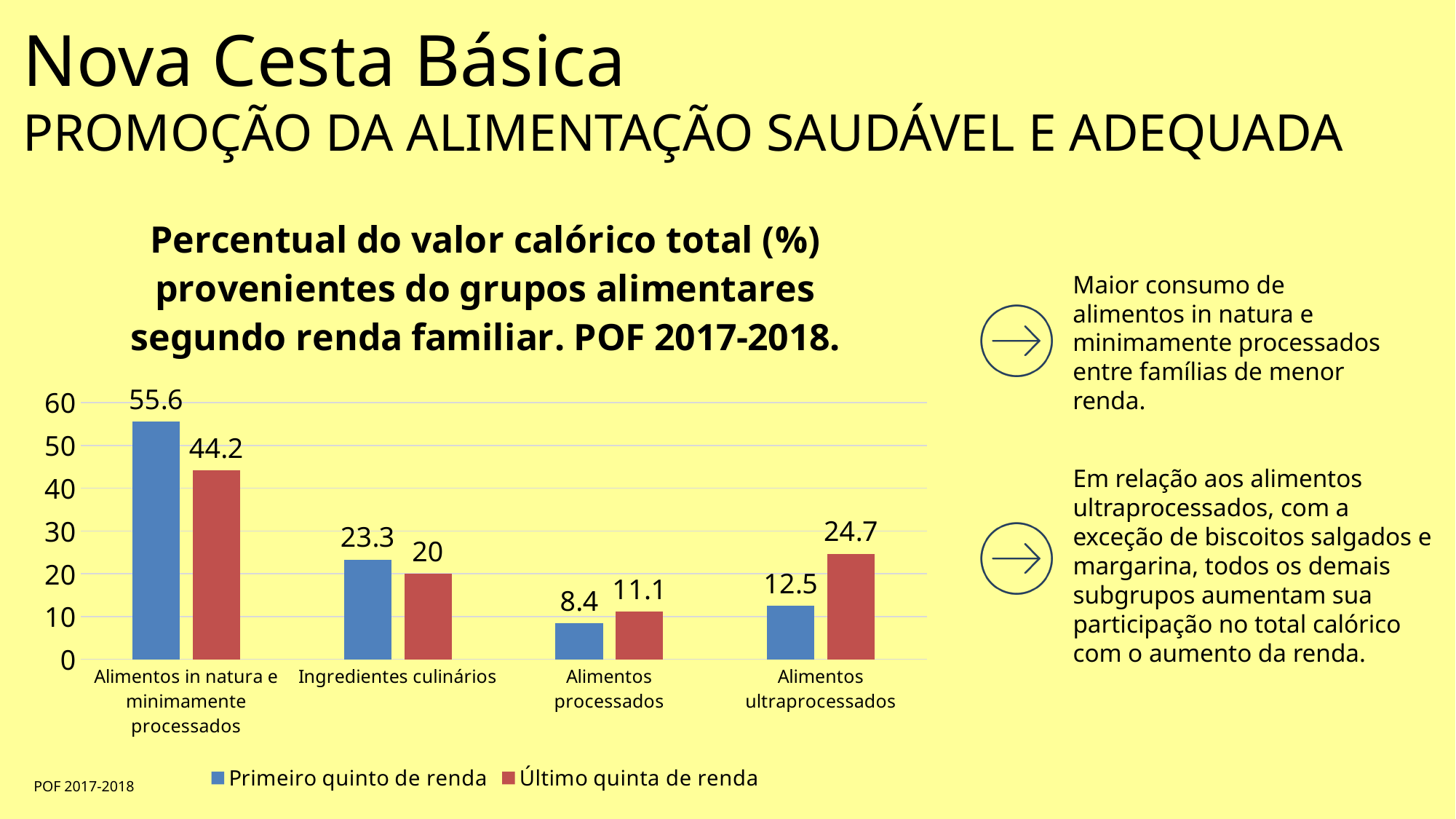
What is the value for 'Alimentos in natura e minimamente processados' in the 'Primeiro quinto de renda' series? 55.6 What is the value for 'Alimentos processados' in the 'Primeiro quinto de renda' series? 8.4 Which category has the lowest value in the 'Último quinta de renda' series? Alimentos processados What is the value for 'Alimentos ultraprocessados' in the 'Último quinta de renda' series? 24.7 What is the difference between the 'Primeiro quinto de renda' and 'Último quinta de renda' values for 'Alimentos in natura e minimamente processados'? 11.4 Which category has the highest value in the 'Primeiro quinto de renda' series? Alimentos in natura e minimamente processados Which is larger for 'Alimentos ultraprocessados': the 'Primeiro quinto de renda' value or the 'Último quinta de renda' value? Último quinta de renda What is the value for 'Ingredientes culinários' in the 'Último quinta de renda' series? 20 How many series does the chart legend list? 2 How many categories are shown on the x axis of the chart? 4 What kind of chart is shown on the slide? Bar chart What colour represents the 'Último quinta de renda' series in the chart? Red